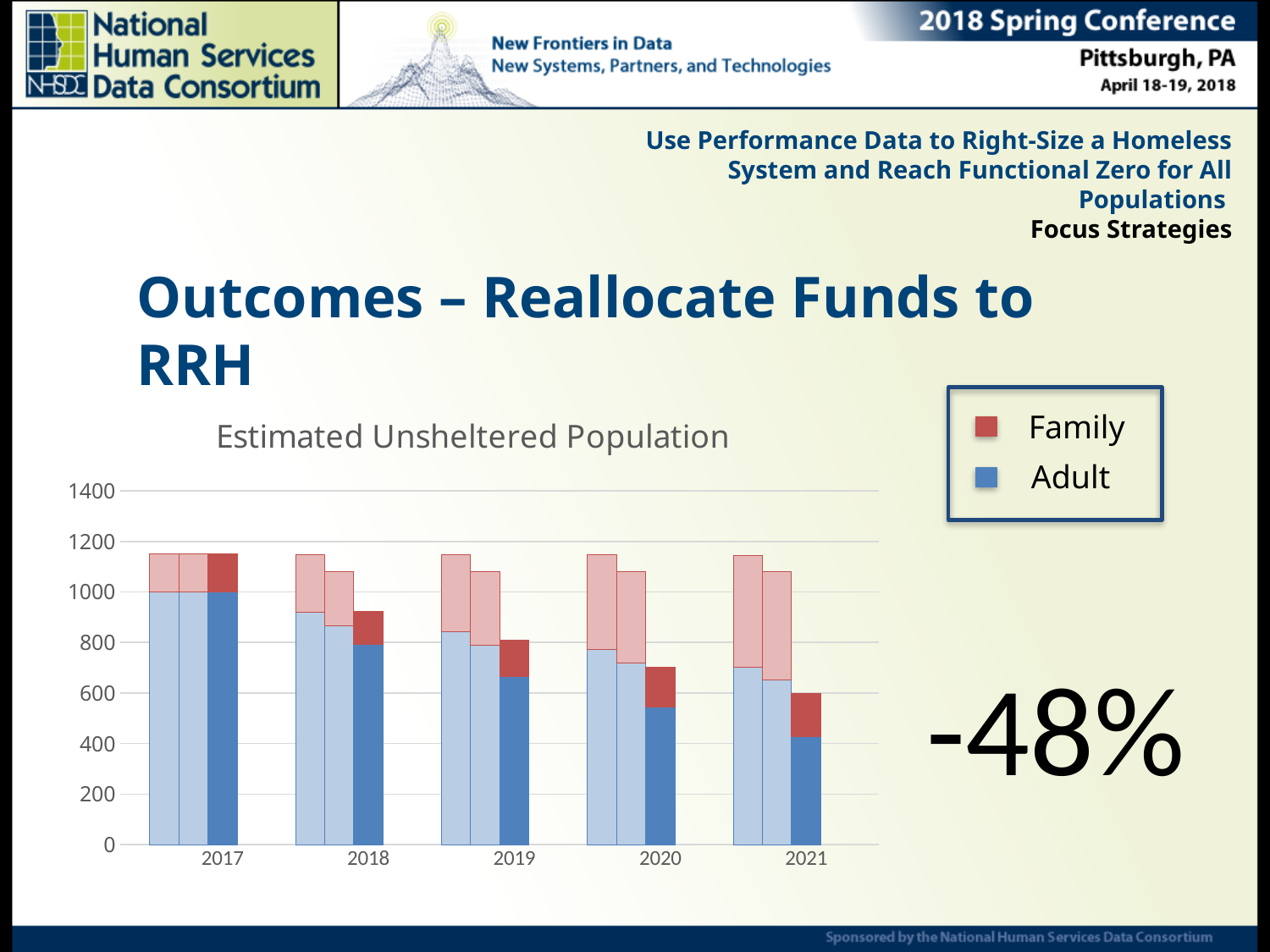
Which series is shown in red in the chart legend? Family Which is larger, the solid stacked bar for 2017 or for 2021? 2017 Is the Adult value in the solid 2018 bar greater or less than 600? greater Is the Adult value in the solid 2017 bar greater or less than 800? greater How many years are shown along the x axis of the chart? 5 Do the solid stacked bars rise or fall from 2017 to 2021? fall Is the total of the solid 2021 bar greater or less than 800? less How many series does the chart legend list? 2 Which year has the shortest solid stacked bar? 2021 What is the title of the chart? Estimated Unsheltered Population Which year has the tallest solid stacked bar? 2017 What kind of chart is shown on the slide? bar chart